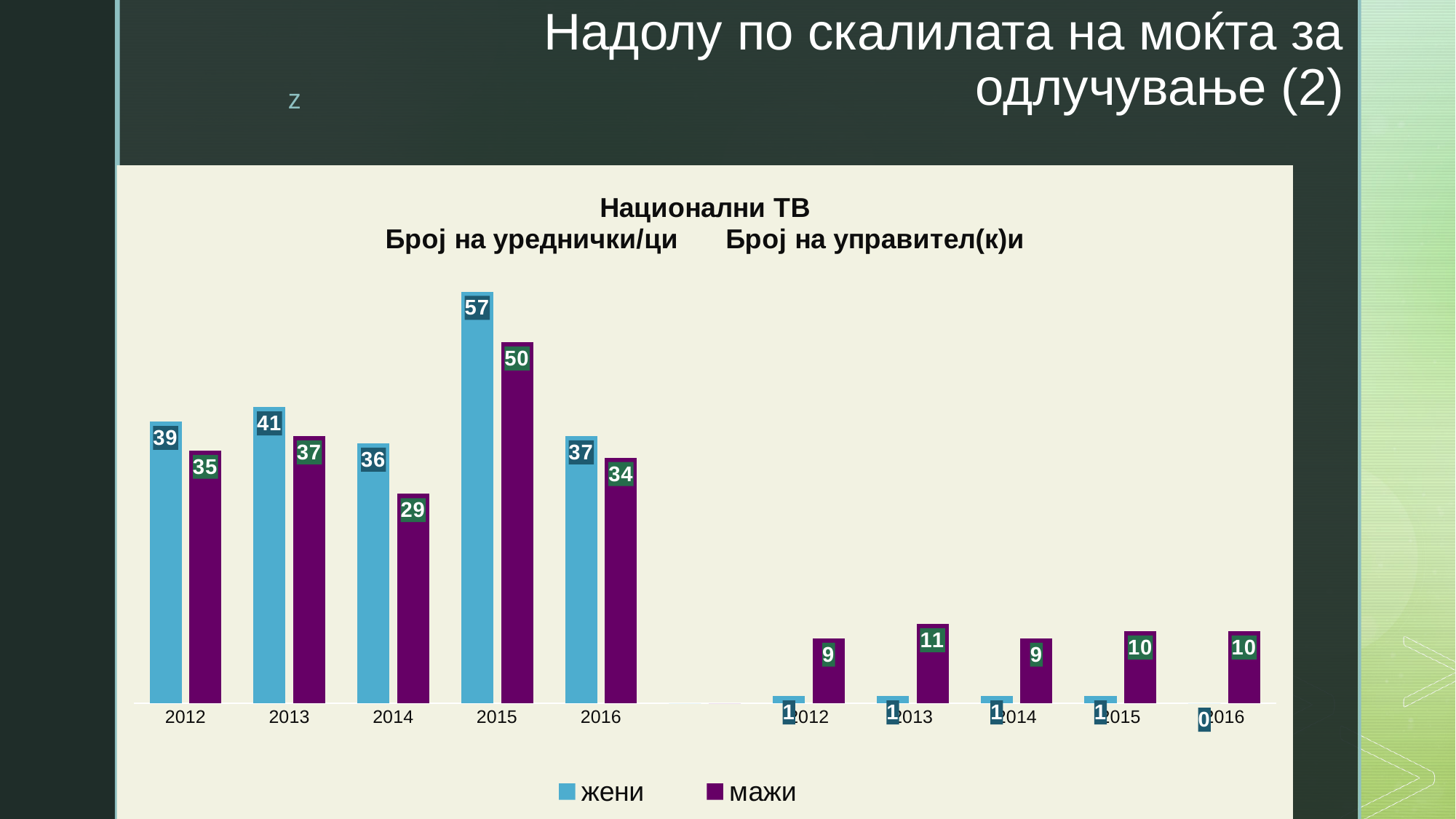
What colour represents the series 'мажи' in the chart? purple In the 'Број на уреднички/ци' section, what is the value for жени in 2015? 57 In the 'Број на уреднички/ци' section, what is the difference between жени and мажи in 2015? 7 In the 'Број на уреднички/ци' section, which year has the lowest value for мажи? 2014 In the 'Број на уреднички/ци' section, what is the value for мажи in 2014? 29 In the 'Број на управител(к)и' section, what is the value for жени in 2016? 0 How many series does the legend list? 2 In the 'Број на управител(к)и' section, what is the value for мажи in 2013? 11 In the 'Број на уреднички/ци' section, which is larger in 2013: жени or мажи? жени In the 'Број на управител(к)и' section, what is the difference between мажи and жени in 2013? 10 In the 'Број на уреднички/ци' section, which year has the highest value for жени? 2015 What kind of chart is shown on the slide? bar chart